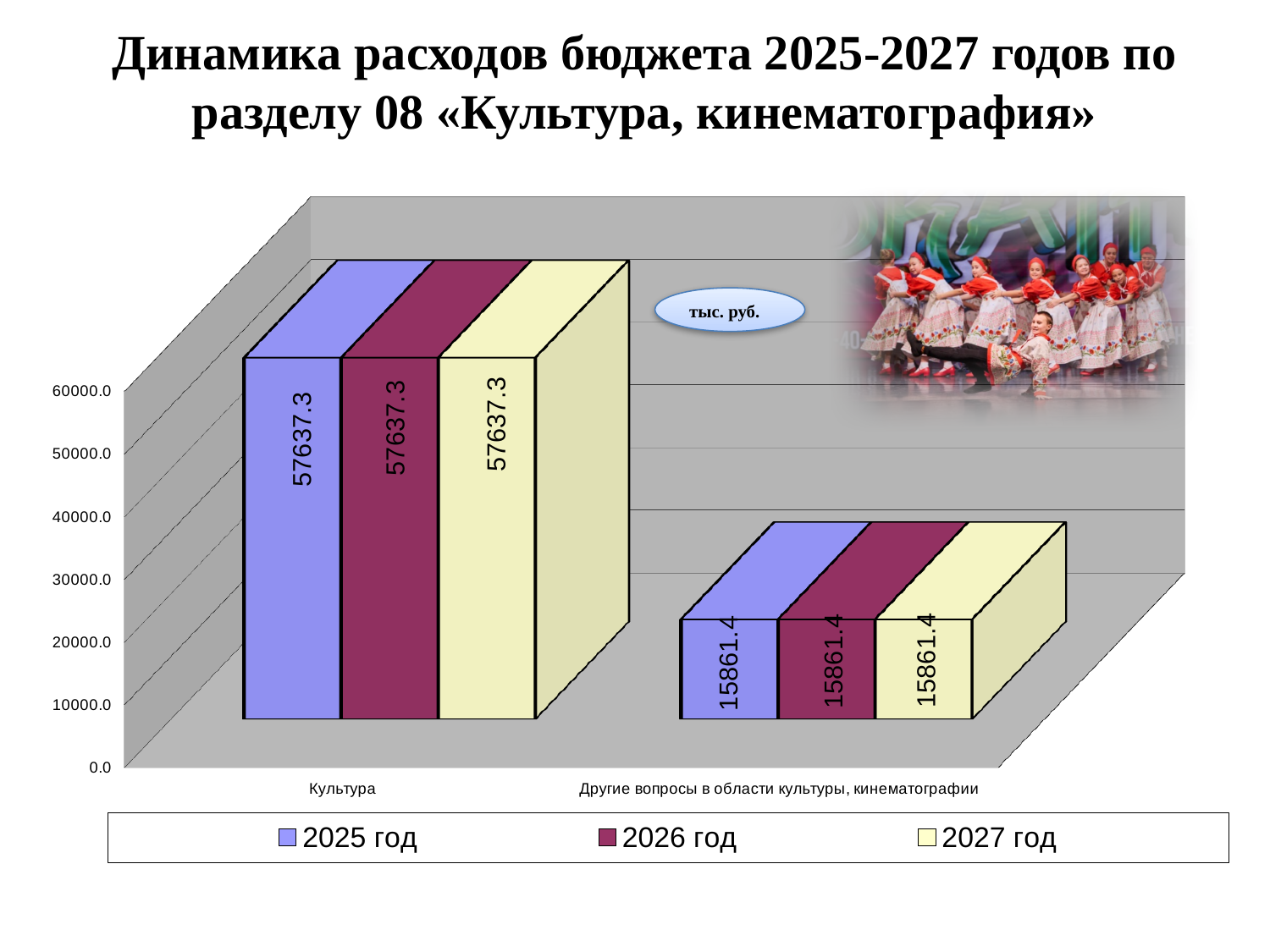
What is the value for Другие вопросы в области культуры, кинематографии in 2027 год? 15861.4 What kind of chart is shown on the slide? bar chart Which category has the lowest value in 2027 год? Другие вопросы в области культуры, кинематографии What is the difference between Культура and Другие вопросы в области культуры, кинематографии in 2026 год? 41775.9 What is the value for Культура in 2025 год? 57637.3 How many categories are shown on the x axis? 2 What unit is indicated in the callout on the chart? тыс. руб. Which is larger in 2025 год: Культура or Другие вопросы в области культуры, кинематографии? Культура How many series does the legend list? 3 What is the value for Культура in 2026 год? 57637.3 Which category has the highest value in 2025 год? Культура Is the value for Культура in 2027 год greater or less than 50000.0? greater